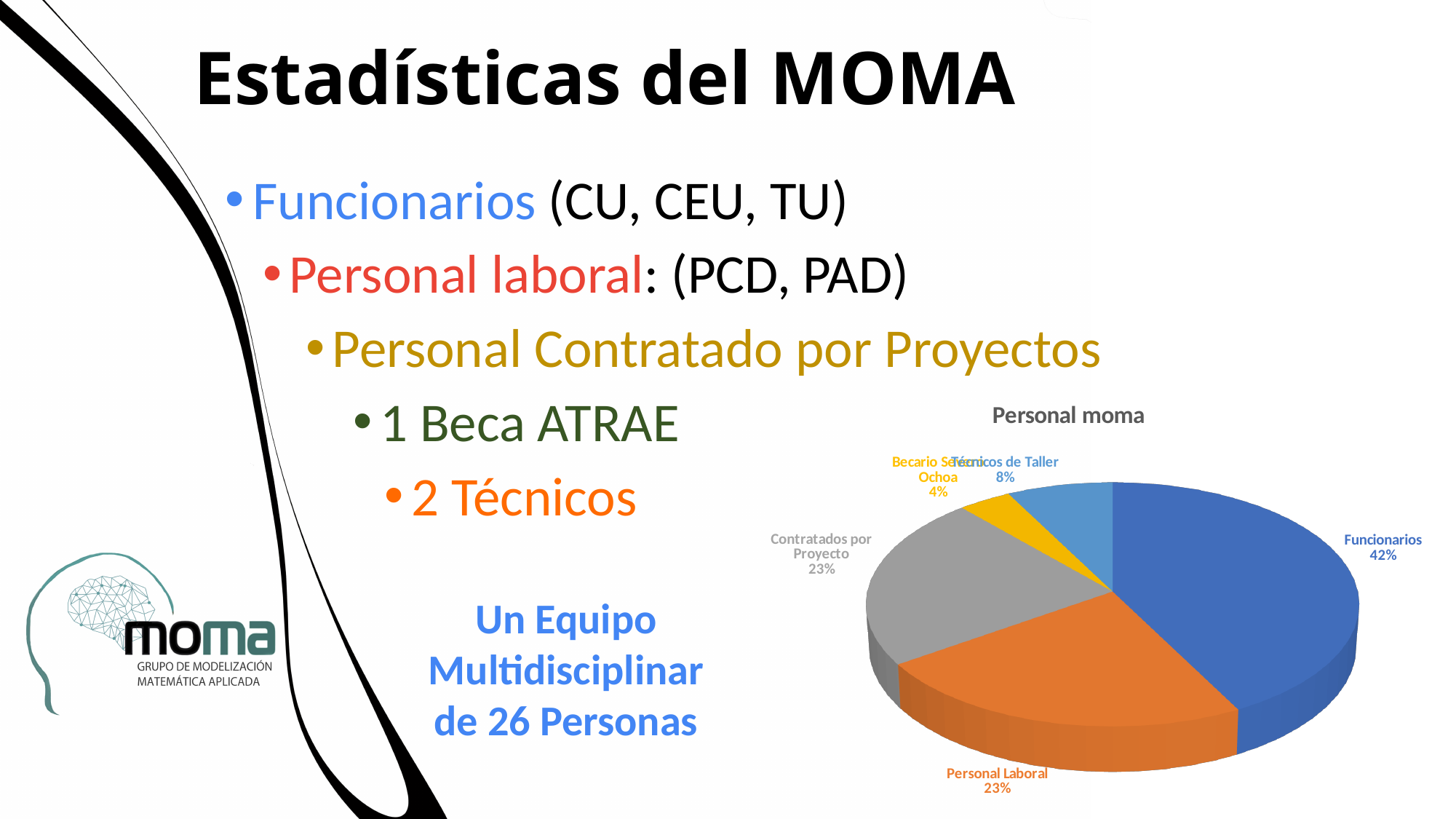
What share of the pie does Técnicos de Taller represent? 8% What is the title of the chart? Personal moma What is the smallest percentage shown on the pie chart? 4% How many slices does the pie chart have? 5 Which is larger, the share for Funcionarios or the share for Técnicos de Taller? Funcionarios What kind of chart is shown on the slide? Pie chart What share of the pie does Contratados por Proyecto represent? 23% What is the difference in percentage points between Contratados por Proyecto and Técnicos de Taller? 15 percentage points What share of the pie does Funcionarios represent? 42% Which category has the largest slice of the pie? Funcionarios What share of the pie does Personal Laboral represent? 23% What is the difference in percentage points between Funcionarios and Personal Laboral? 19 percentage points